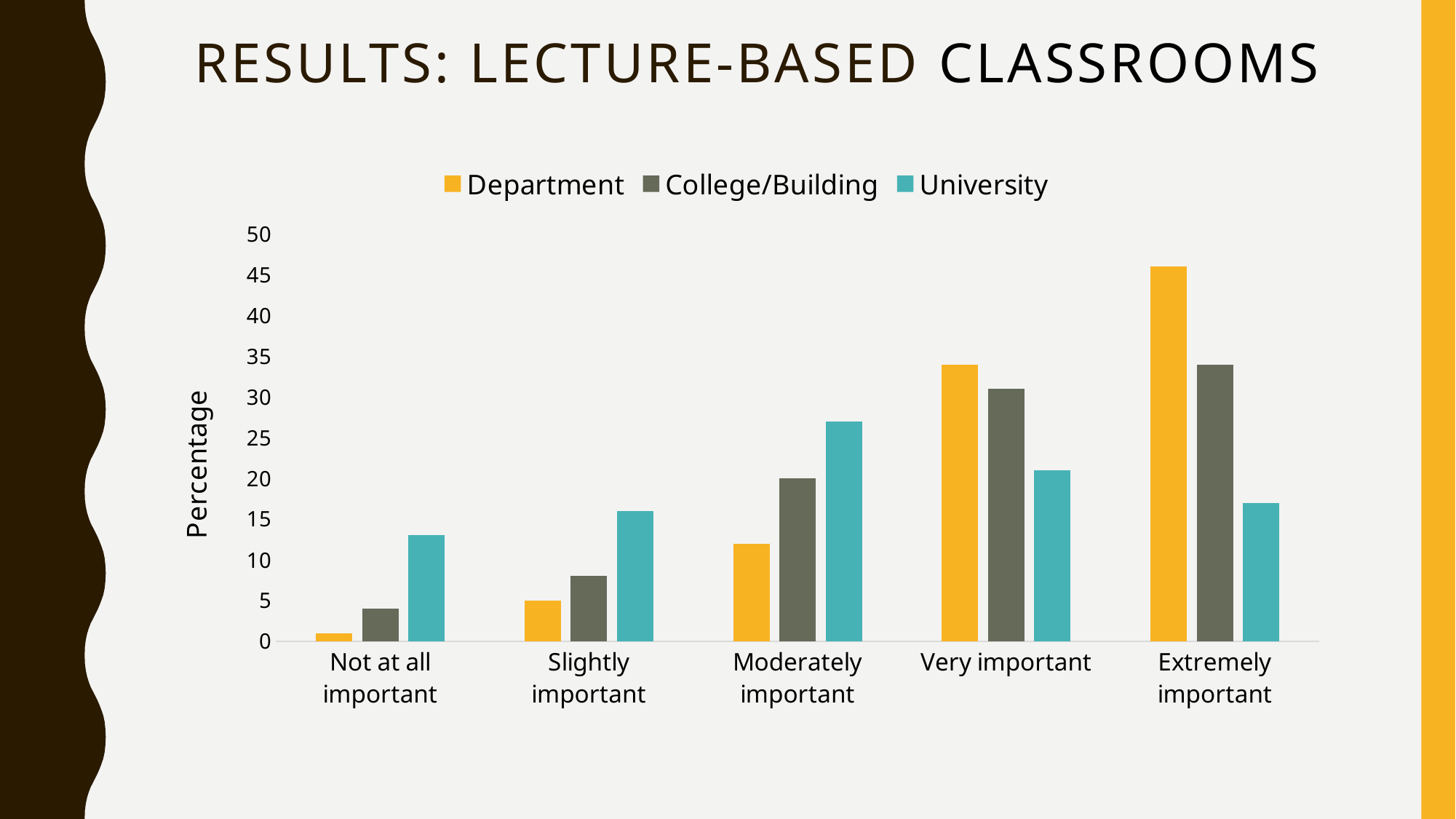
How many series does the legend list? 3 What kind of chart is shown on the slide? bar chart Is the value for University in the Moderately important category greater or less than 25? greater For which category is the College/Building series highest? Extremely important How many categories are shown on the x axis? 5 Is the value for Department in the Extremely important category greater or less than 40? greater For which category is the Department series highest? Extremely important For which category is the University series lowest? Not at all important In the Extremely important category, which is larger: Department or University? Department What is the label on the y axis? Percentage Do the Department values rise or fall moving from Not at all important to Extremely important? rise Is the value for College/Building in the Not at all important category greater or less than 5? less